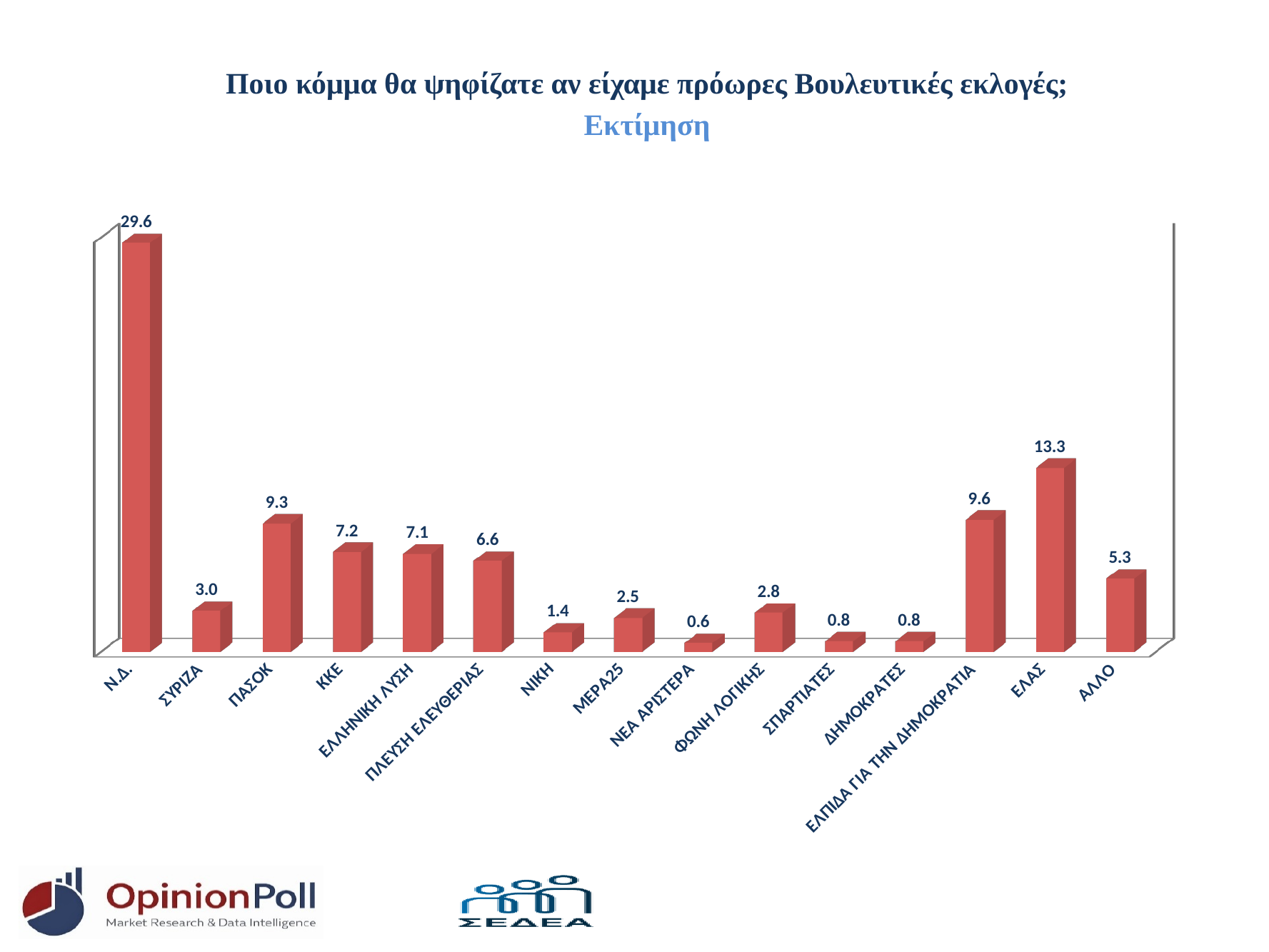
What value is shown for ΕΛΑΣ? 13.3 How many categories (bars) are shown in the chart? 15 What value is shown for ΕΛΠΙΔΑ ΓΙΑ ΤΗΝ ΔΗΜΟΚΡΑΤΙΑ? 9.6 What is the difference between the values for ΠΑΣΟΚ and ΚΚΕ? 2.1 Which party has the highest value in the chart? Ν.Δ. Which has a larger value, ΣΥΡΙΖΑ or ΑΛΛΟ? ΑΛΛΟ Which has a larger value, ΜΕΡΑ25 or ΦΩΝΗ ΛΟΓΙΚΗΣ? ΦΩΝΗ ΛΟΓΙΚΗΣ What value is shown for Ν.Δ.? 29.6 What is the difference between the values for Ν.Δ. and ΕΛΑΣ? 16.3 What value is shown for ΠΛΕΥΣΗ ΕΛΕΥΘΕΡΙΑΣ? 6.6 What kind of chart is shown on the slide? Bar chart Which party has the lowest value in the chart? ΝΕΑ ΑΡΙΣΤΕΡΑ